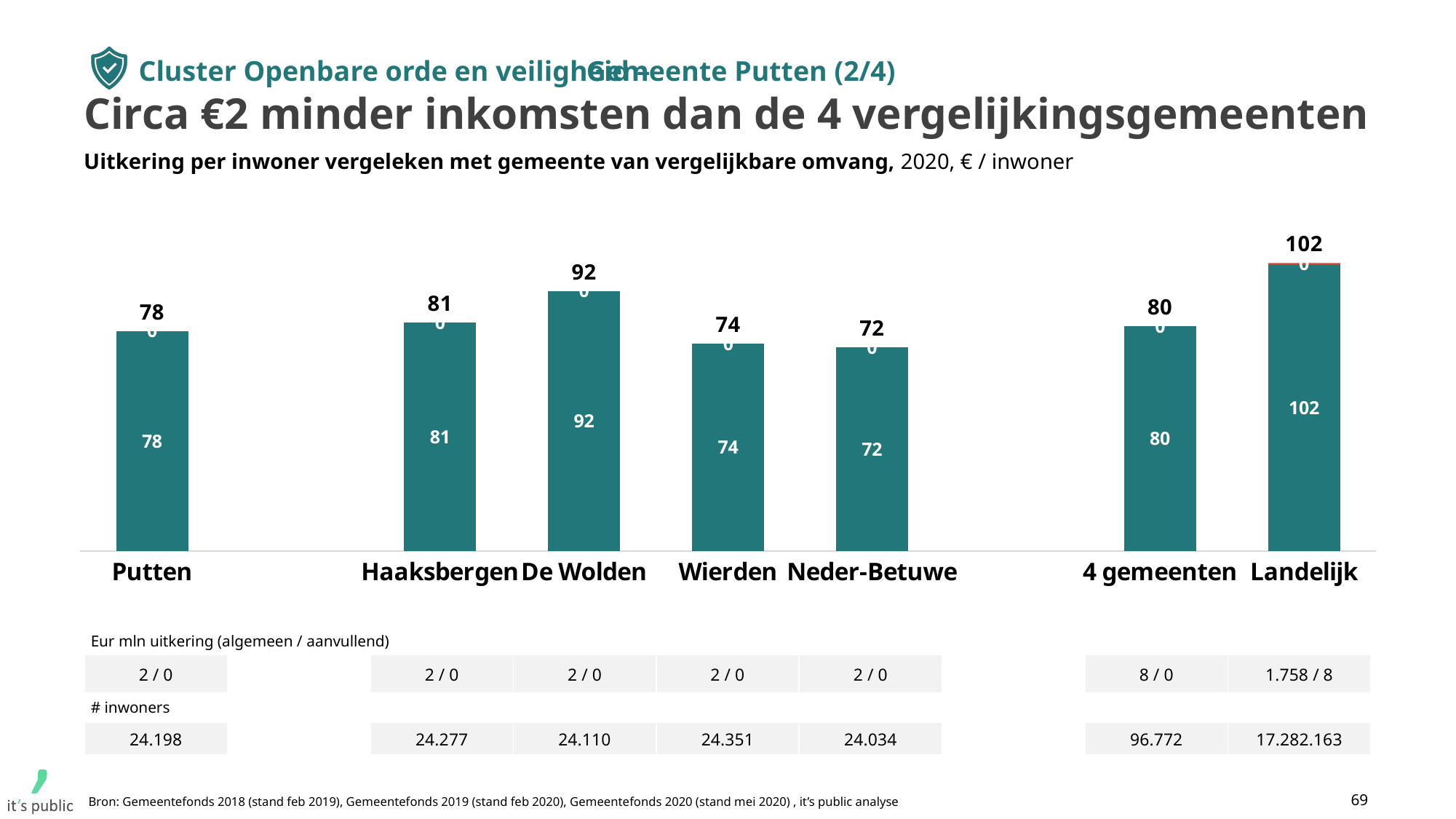
What is the value for Neder-Betuwe? 72 Which category has the lowest value? Neder-Betuwe What is the value for Putten? 78 What is the value for Landelijk? 102 What unit is stated in the chart subtitle? € / inwoner What is the value for De Wolden? 92 What is the difference between the values for 4 gemeenten and Putten? 2 Which category has the highest value? Landelijk What is the difference between the values for De Wolden and Wierden? 18 What kind of chart is shown on the slide? bar chart How many categories are shown on the x axis? 7 Which is larger, the value for Haaksbergen or the value for Wierden? Haaksbergen